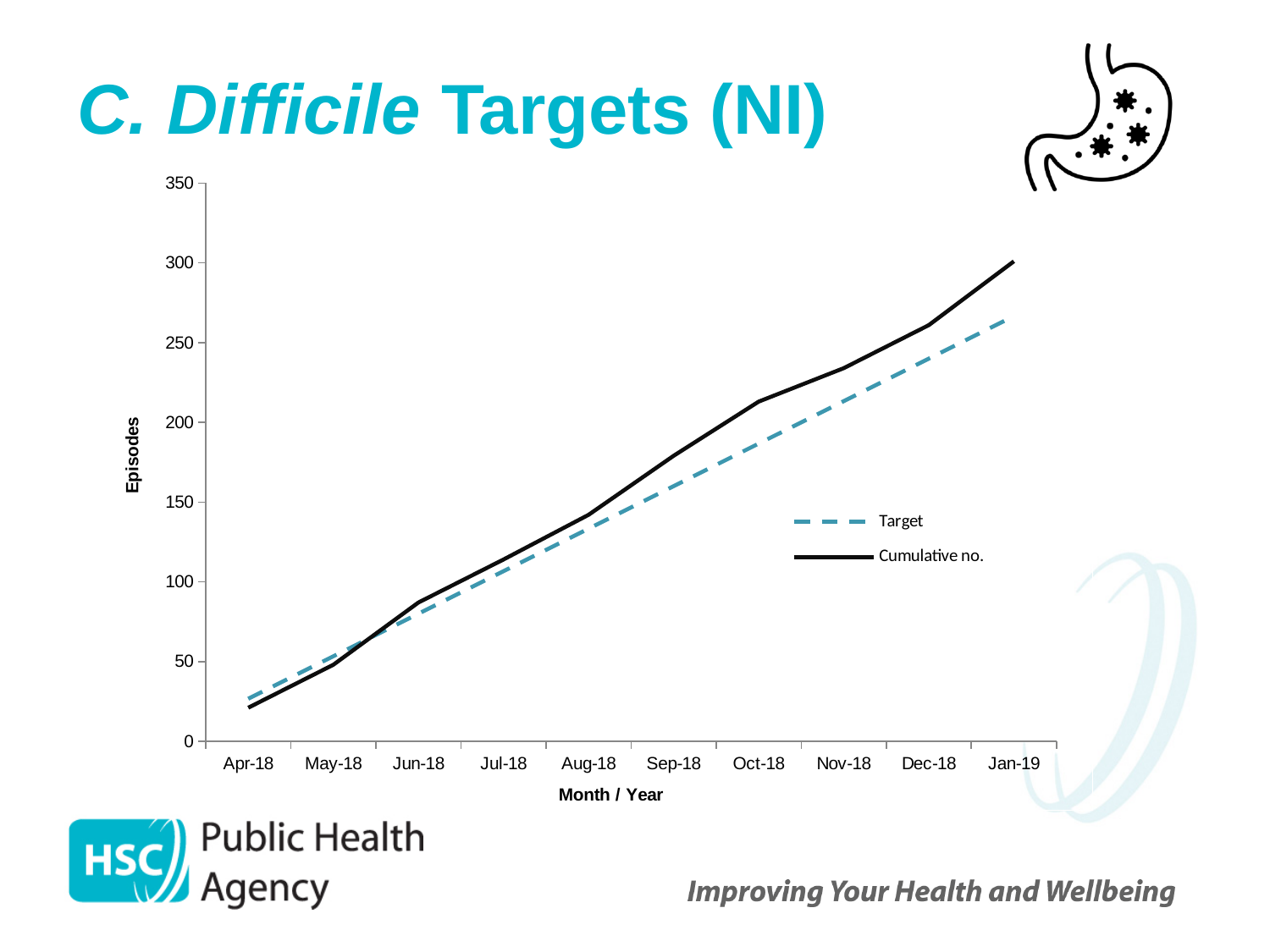
Is the Cumulative no. value for Oct-18 greater or less than 200? greater Is the Target value for Apr-18 greater or less than 50? less What is the title of the y axis? Episodes At Jan-19, which series has the higher value, Target or Cumulative no.? Cumulative no. At Dec-18, which series has the higher value, Target or Cumulative no.? Cumulative no. Does the Cumulative no. line rise or fall from Apr-18 to Jan-19? Rise What kind of chart is shown on the slide? Line chart Is the Target value for Jan-19 greater or less than 300? less How many months are shown on the x axis? 10 How many series does the legend list? 2 In which month does the Cumulative no. line reach its highest value? Jan-19